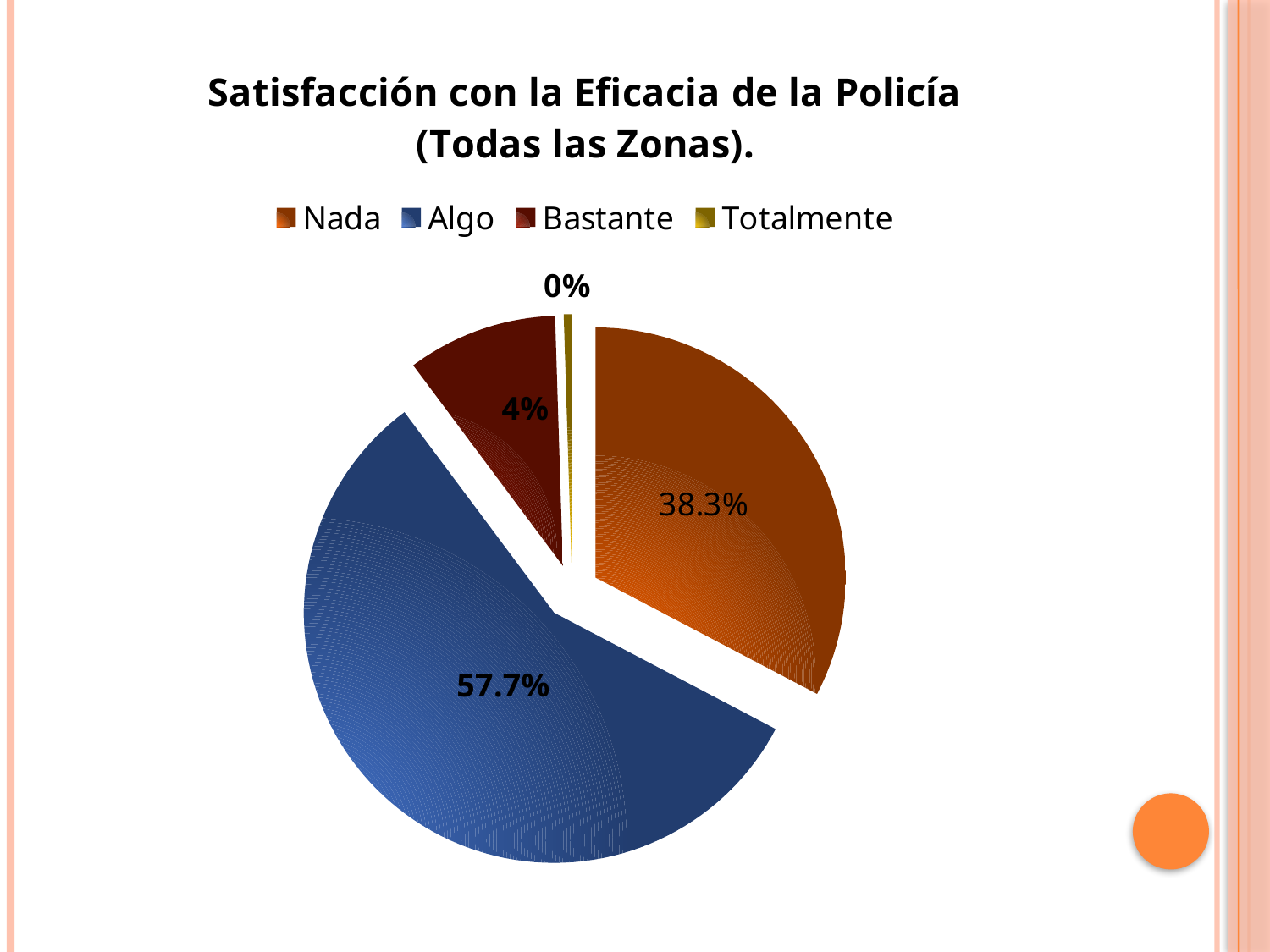
Which category has the smallest slice of the pie? Totalmente Which category has the largest slice of the pie? Algo What share of the pie is labelled for Nada? 38.3% Which is larger, the slice for Nada or the slice for Algo? Algo How many categories does the legend list? 4 Which legend entry is shown in blue? Algo What share of the pie is labelled for Algo? 57.7% What share of the pie is labelled for Totalmente? 0% What is the title of the chart? Satisfacción con la Eficacia de la Policía (Todas las Zonas). What kind of chart is shown on the slide? pie chart What share of the pie is labelled for Bastante? 4% What is the difference in percentage points between the Algo slice and the Nada slice? 19.4